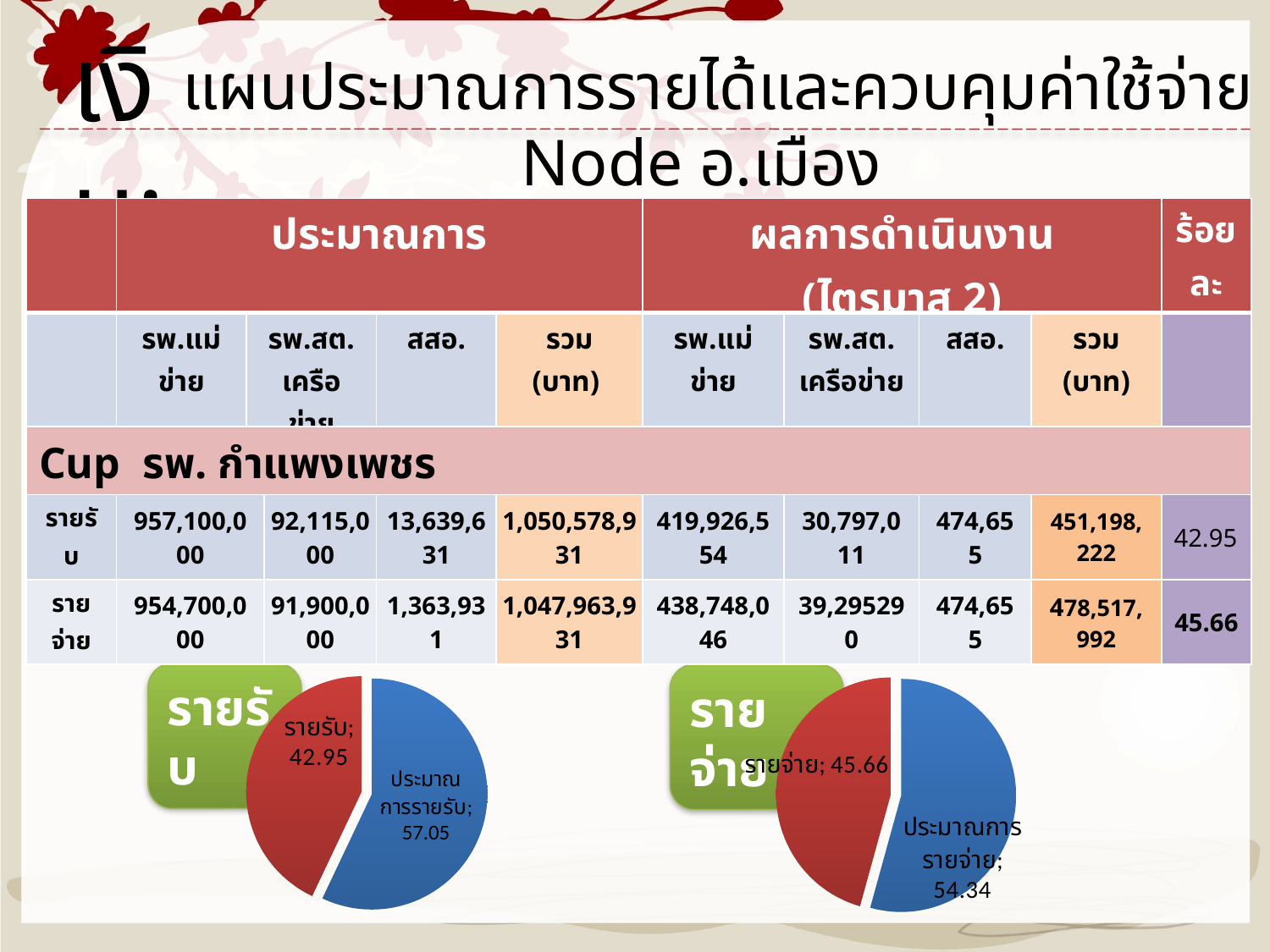
How many slices does the left pie chart (รายรับ) have? 2 Which is larger: the รายรับ slice in the left pie chart or the รายจ่าย slice in the right pie chart? รายจ่าย In the left pie chart (รายรับ), what value is shown for the slice labelled ประมาณการรายรับ? 57.05 What type of chart is used for รายจ่าย on the right side of the slide? Pie chart In the left pie chart (รายรับ), what is the difference between the ประมาณการรายรับ slice and the รายรับ slice? 14.10 In the left pie chart (รายรับ), what value is shown for the slice labelled รายรับ? 42.95 In the right pie chart (รายจ่าย), what colour is the ประมาณการรายจ่าย slice? Blue In the right pie chart (รายจ่าย), what is the difference between the ประมาณการรายจ่าย slice and the รายจ่าย slice? 8.68 In the right pie chart (รายจ่าย), what value is shown for the slice labelled รายจ่าย? 45.66 In the left pie chart (รายรับ), which slice is the largest? ประมาณการรายรับ In the right pie chart (รายจ่าย), what value is shown for the slice labelled ประมาณการรายจ่าย? 54.34 In the right pie chart (รายจ่าย), which slice is the smallest? รายจ่าย